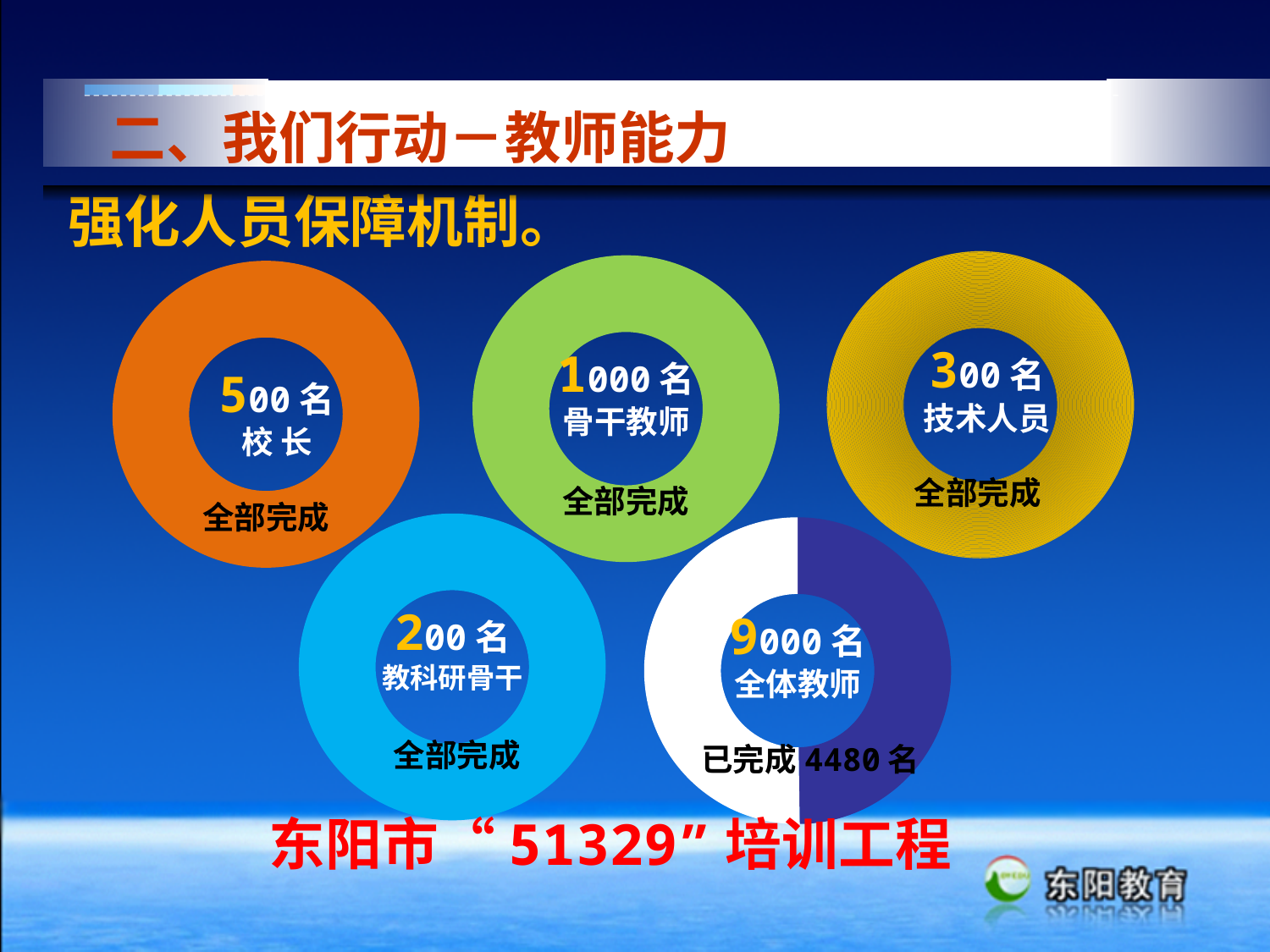
In the purple-and-white donut chart for 全体教师, how many teachers have completed training (已完成)? 4480 名 What kind of chart is used to show each training group on the slide? Donut chart Which training group has the largest target number across the five donut charts? 全体教师 (9000 名) Which training group has the smallest target number across the five donut charts? 教科研骨干 (200 名) In the yellow donut chart, how many 技术人员 are targeted for training? 300 名 In the green donut chart, how many 骨干教师 are targeted for training? 1000 名 In the 全体教师 donut chart, how many teachers remain to complete training out of the 9000 target, given 4480 are completed? 4520 名 In the light blue donut chart, how many 教科研骨干 are targeted for training? 200 名 In the orange donut chart, how many 校长 (principals) are targeted for training? 500 名 How many donut charts are shown on the slide? 5 Which target is larger: 骨干教师 in the green chart or 校长 in the orange chart? 骨干教师 What completion status is shown under the orange 校长 donut chart? 全部完成